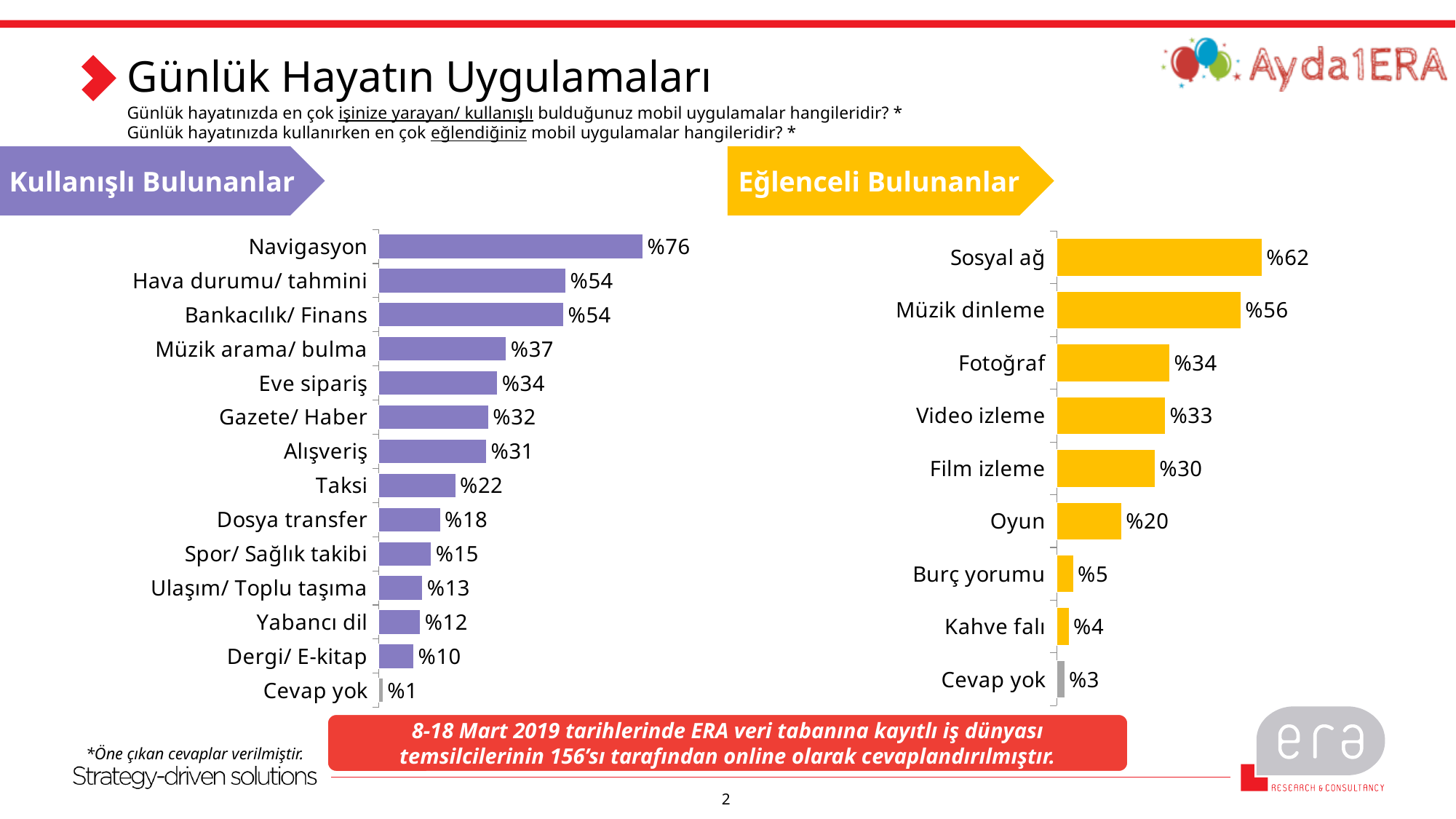
How many categories are shown in the Kullanışlı Bulunanlar chart? 14 In the Kullanışlı Bulunanlar chart, what is the value for Taksi? %22 In the Kullanışlı Bulunanlar chart, which category has the lowest value? Cevap yok In the Eğlenceli Bulunanlar chart, what is the difference between Sosyal ağ and Fotoğraf? %28 In the Eğlenceli Bulunanlar chart, what is the value for Oyun? %20 In the Eğlenceli Bulunanlar chart, what is the value for Müzik dinleme? %56 In the Kullanışlı Bulunanlar chart, what is the value for Navigasyon? %76 How many categories are shown in the Eğlenceli Bulunanlar chart? 9 In the Eğlenceli Bulunanlar chart, which category has the highest value? Sosyal ağ What type of chart is the Kullanışlı Bulunanlar chart? Bar chart In the Kullanışlı Bulunanlar chart, what is the difference between Navigasyon and Hava durumu/ tahmini? %22 In the Kullanışlı Bulunanlar chart, which is larger: Eve sipariş or Gazete/ Haber? Eve sipariş